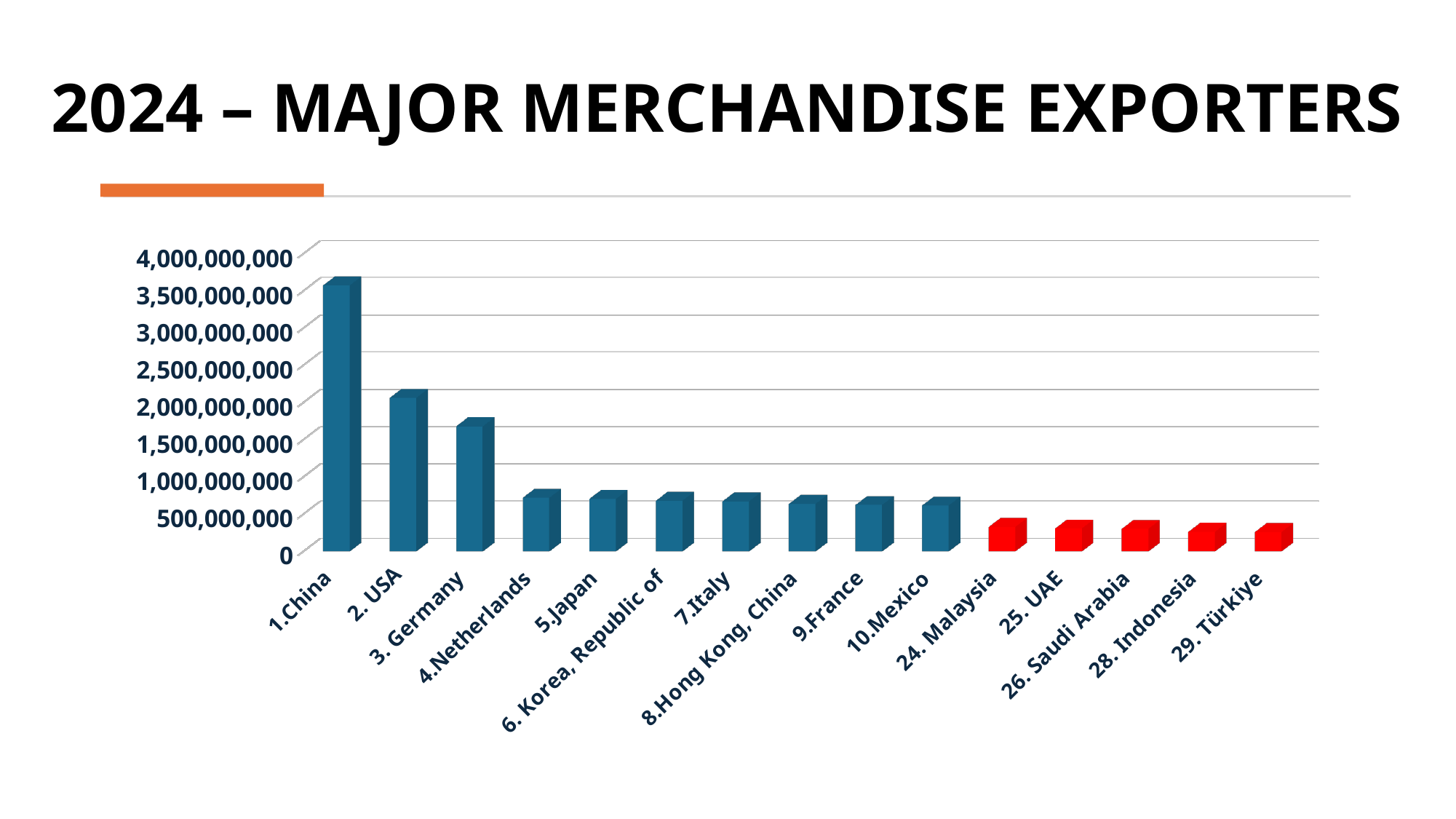
Do the bar values generally rise or fall moving from left to right along the x axis? fall Is the value for 1.China greater or less than 3,000,000,000? greater Is the value for 24. Malaysia greater or less than 500,000,000? less Which is larger, the value for 10.Mexico or the value for 24. Malaysia? 10.Mexico What is the title of the slide? 2024 – MAJOR MERCHANDISE EXPORTERS How many countries are shown on the x axis of the chart? 15 Which is larger, the value for 1.China or the value for 2. USA? 1.China Is the value for 3. Germany greater or less than 1,500,000,000? greater What kind of chart is shown on the slide? bar chart Which country has the highest bar in the chart? 1.China Which is larger, the value for 3. Germany or the value for 4.Netherlands? 3. Germany